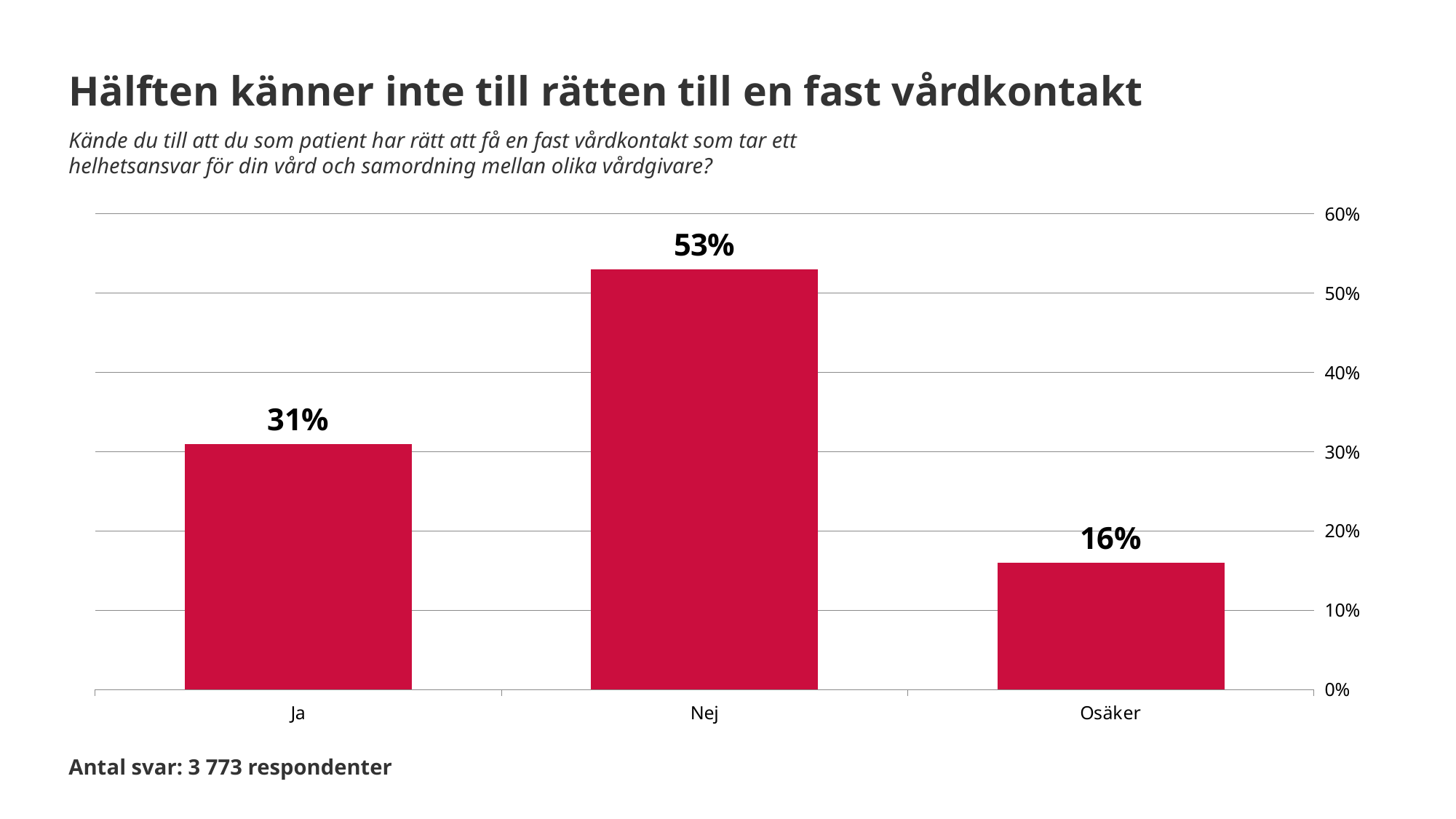
Which is larger, the value for Ja or the value for Osäker? Ja What is the value for Ja? 31% How many categories are shown on the x axis? 3 What is the difference between the values for Nej and Ja? 22% What kind of chart is shown on the slide? bar chart What is the value for Nej? 53% What is the value for Osäker? 16% What is the difference between the values for Ja and Osäker? 15% Which category has the highest value? Nej Is the value for Nej greater or less than 50%? greater How many respondents answered the survey, according to the note below the chart? 3 773 Which category has the lowest value? Osäker